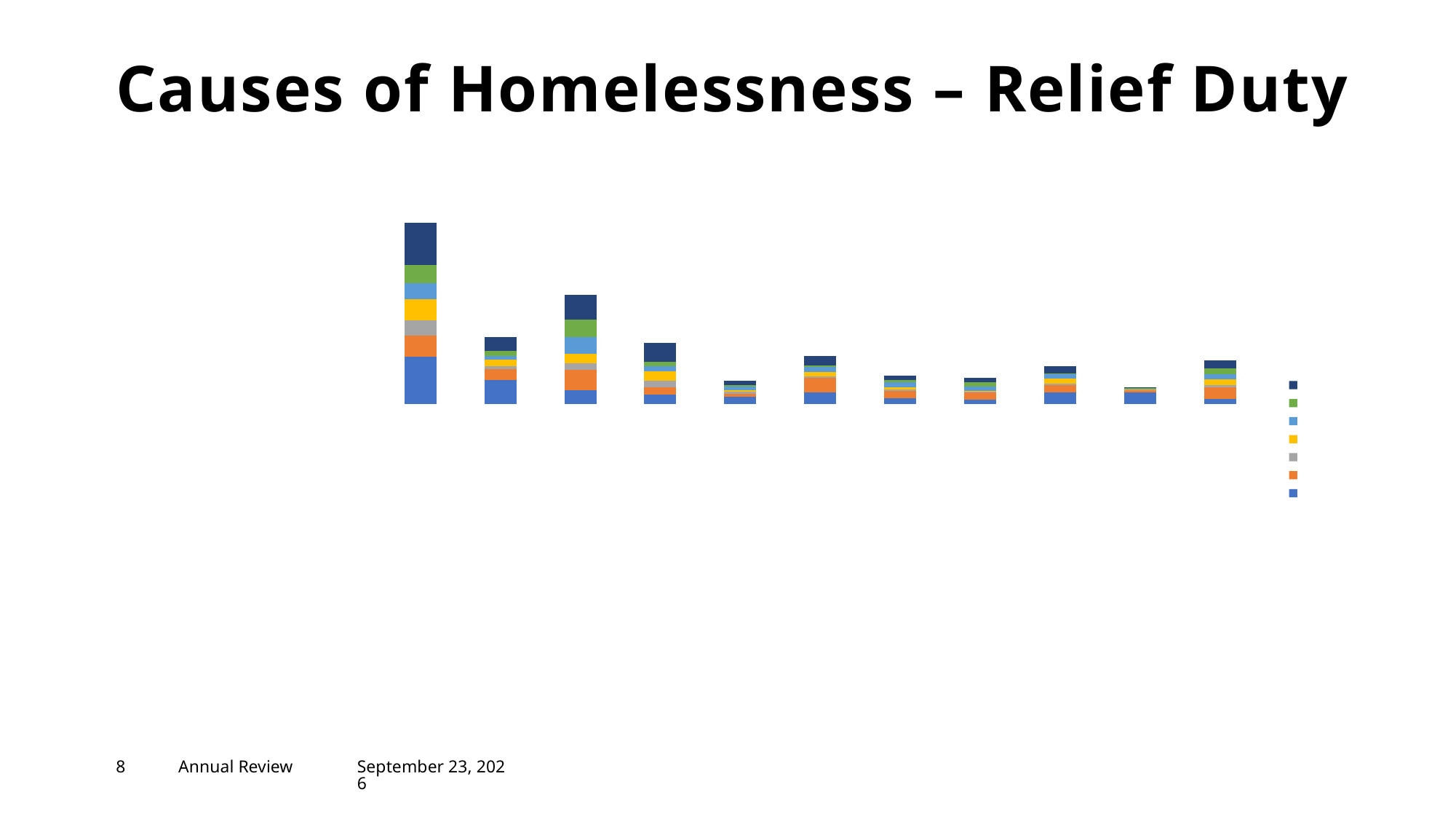
Counting from the left, which bar is the tallest in the chart? the first bar Counting from the left, which bar is the shortest in the chart? the tenth bar Which is taller, the first bar from the left or the third bar from the left? the first bar Which colour is the bottom segment of each stacked bar? blue How many series does the chart's legend list? 7 What kind of chart is shown on the slide? stacked bar chart How many bars (categories) are plotted in the chart? 11 What is the title of the slide containing the chart? Causes of Homelessness – Relief Duty Which is taller, the second bar from the left or the fifth bar from the left? the second bar